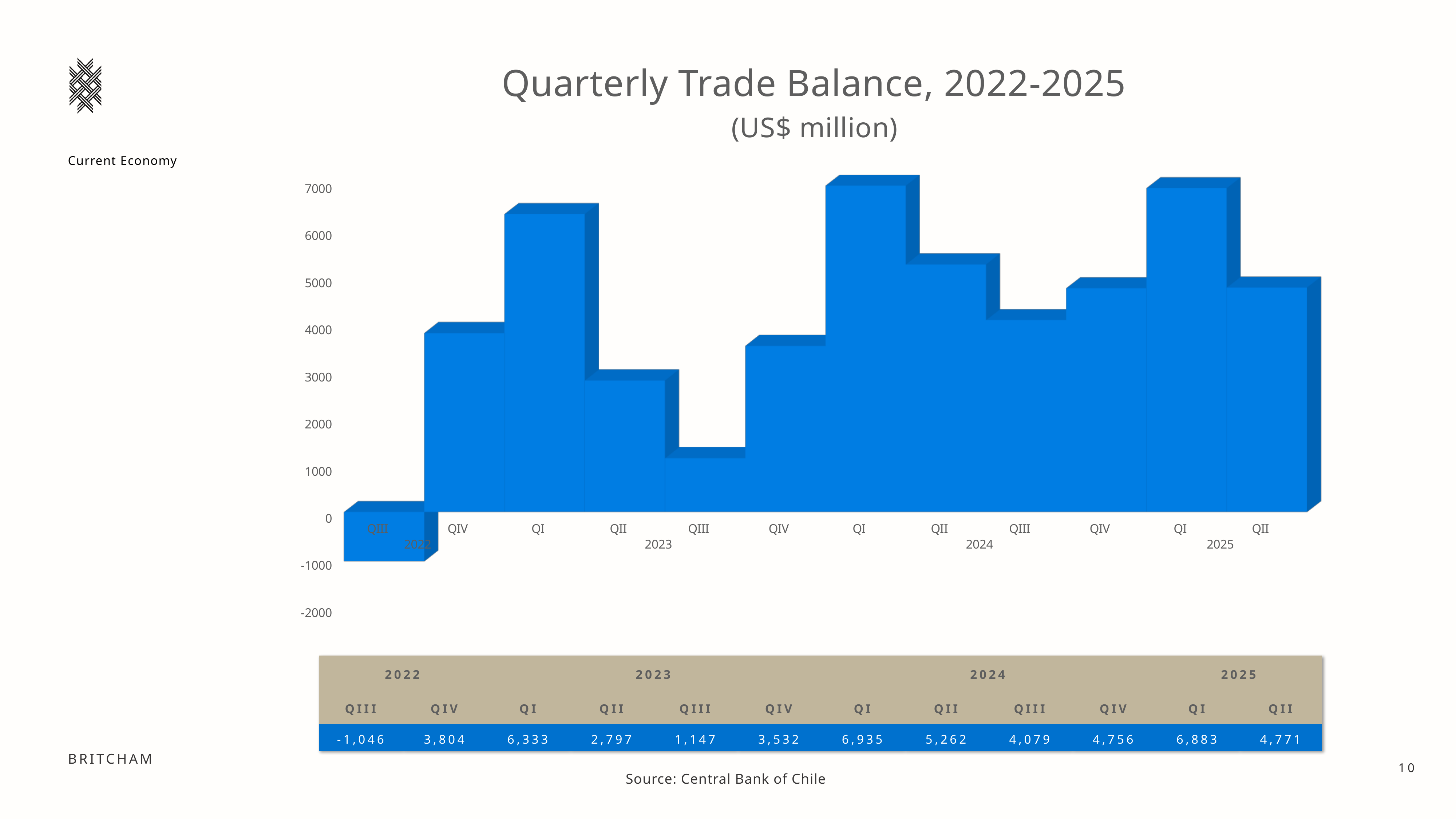
How many quarters are plotted in the chart? 12 Which is larger, the trade balance in QII 2024 or QIV 2024? QII 2024 What is the trade balance for QII 2025? 4,771 Which quarter has the lowest trade balance? QIII 2022 What is the difference between the trade balance in QI 2023 and QII 2023? 3,536 Do the values rise or fall from QI 2023 to QIII 2023? fall What is the trade balance for QI 2023? 6,333 Is the value for QIII 2023 greater or less than 2000? less What is the trade balance for QIII 2022? -1,046 What is the trade balance for QIV 2024? 4,756 What kind of chart is shown on the slide? bar chart Which quarter has the highest trade balance? QI 2024